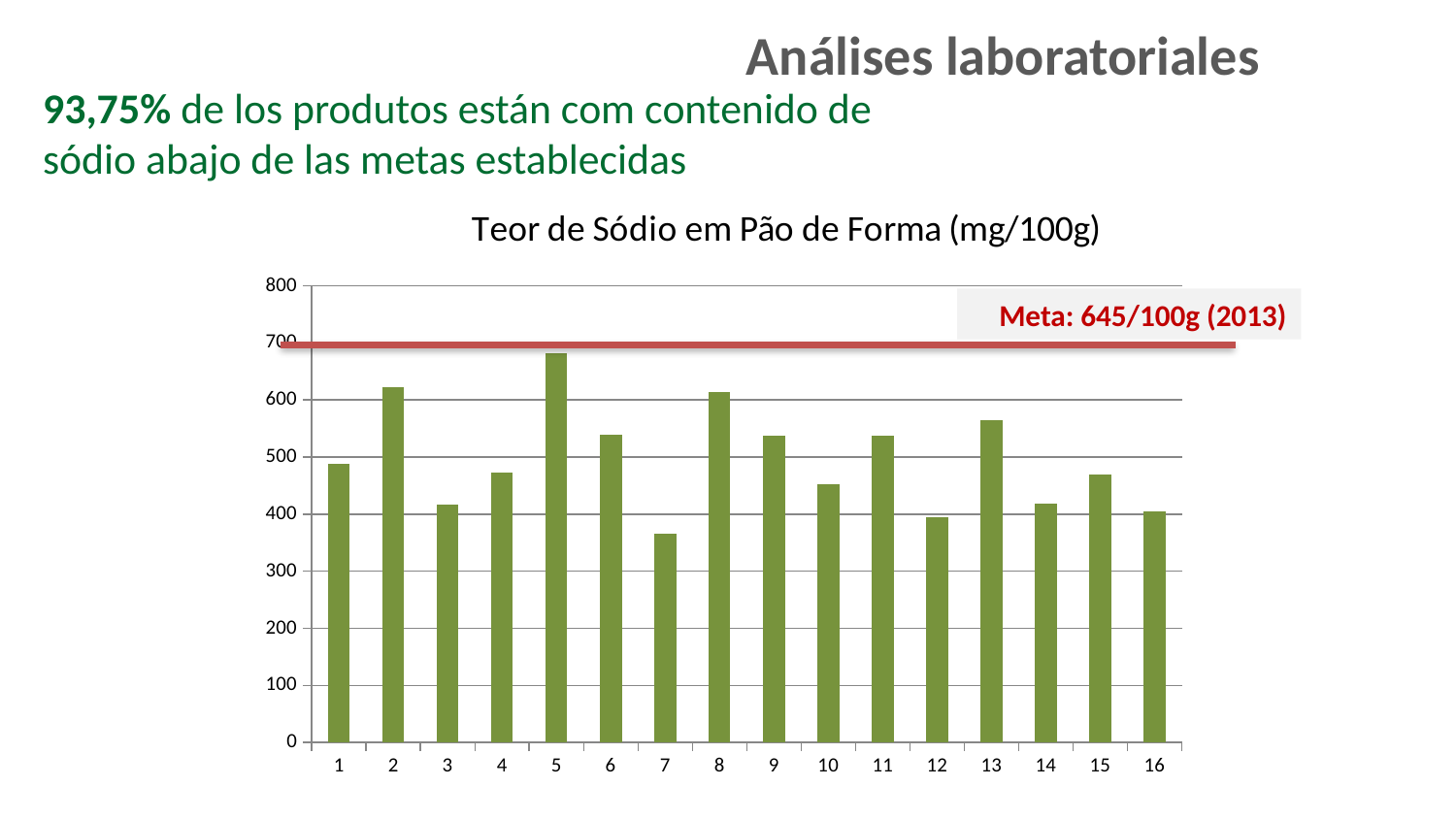
What is the title of the chart? Teor de Sódio em Pão de Forma (mg/100g) Is the value for product 10 greater or less than 500? less Is the value for product 2 greater or less than 600? greater Is the value for product 5 greater or less than 600? greater Which has a higher sodium content, product 8 or product 10? product 8 What kind of chart is shown on the slide? bar chart How many bars (products) are plotted in the chart? 16 What target (meta) is labelled next to the red line on the chart? Meta: 645/100g (2013) Which product number has the lowest sodium content in the chart? 7 Which product number has the highest sodium content in the chart? 5